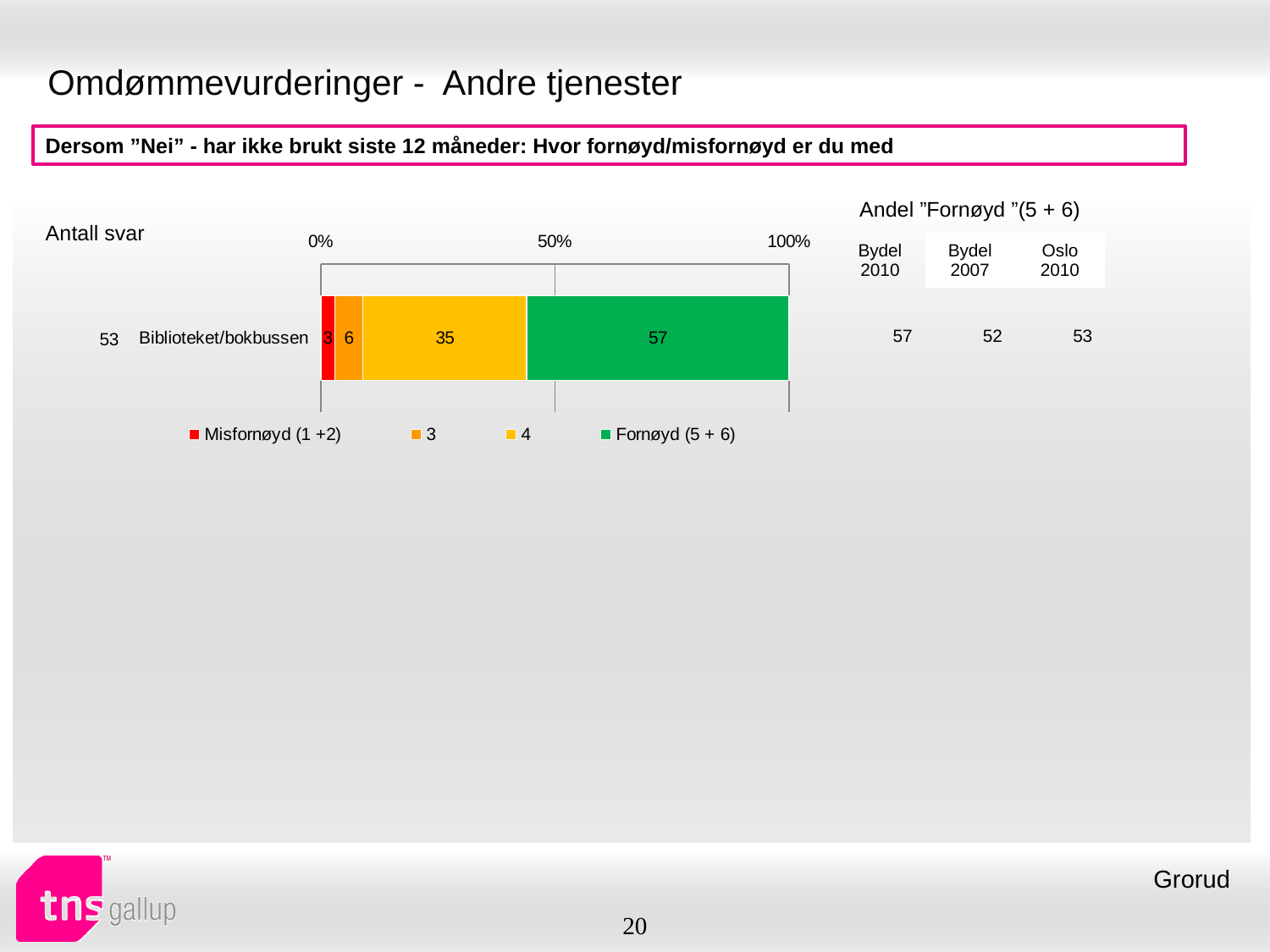
How many categories are plotted in the chart? 1 Which segment of the Biblioteket/bokbussen bar is the largest? Fornøyd (5 + 6) What is the difference between the Fornøyd (5 + 6) segment and the segment labelled 4 for Biblioteket/bokbussen? 22 What is the value of the segment labelled 3 for Biblioteket/bokbussen? 6 What is the value of the Fornøyd (5 + 6) segment for Biblioteket/bokbussen? 57 What is the value of the segment labelled 4 for Biblioteket/bokbussen? 35 What kind of chart is shown on the slide? Stacked bar chart How many series does the legend list? 4 Which segment of the Biblioteket/bokbussen bar is the smallest? Misfornøyd (1 +2) Which is larger for Biblioteket/bokbussen: the segment labelled 3 or the Misfornøyd (1 +2) segment? 3 What is the value of the Misfornøyd (1 +2) segment for Biblioteket/bokbussen? 3 What is the total of the stacked bar for Biblioteket/bokbussen? 101